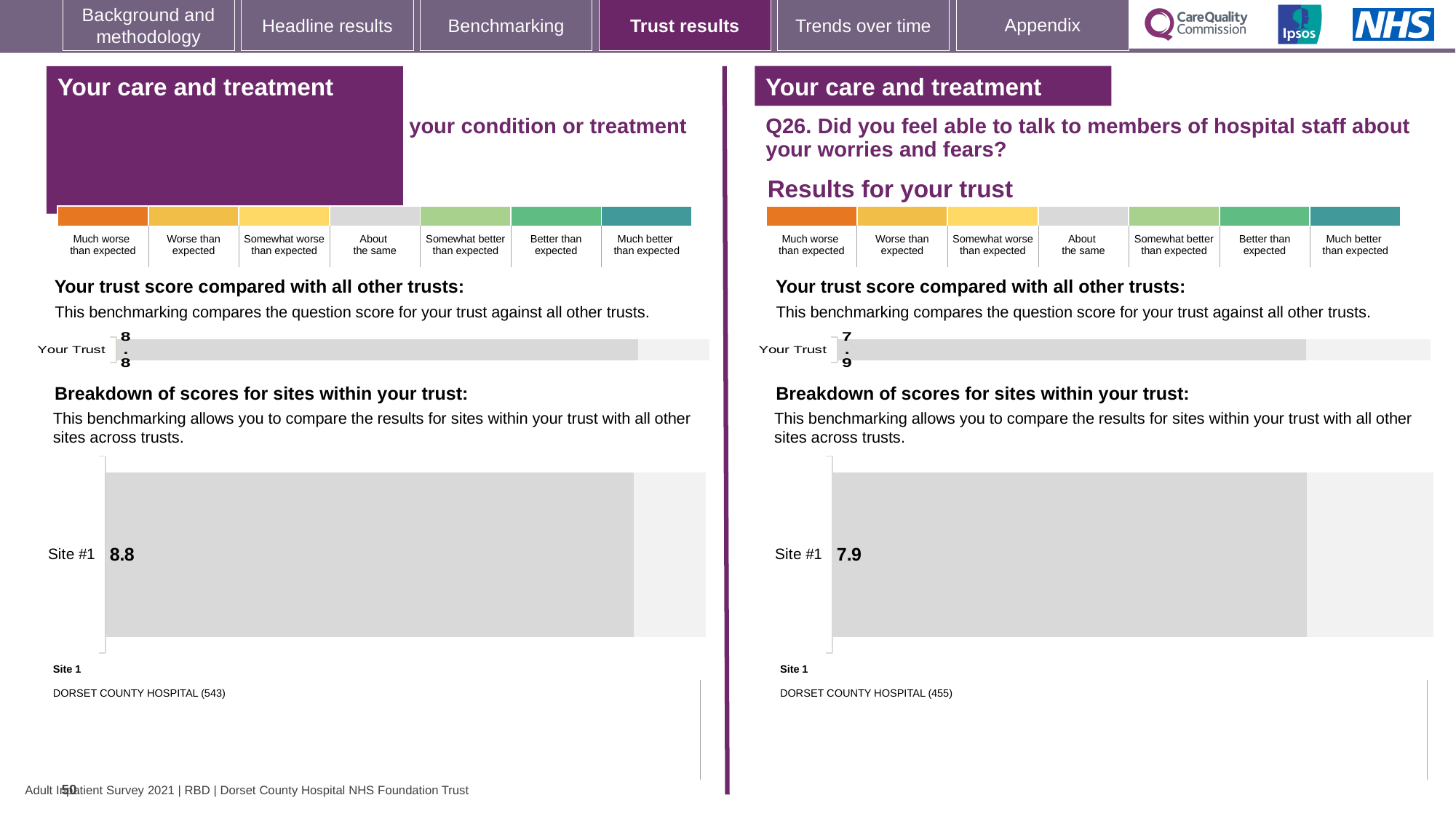
On the right half of the slide, which site name is listed under Site 1 in the breakdown of scores? DORSET COUNTY HOSPITAL (455) On the left half of the slide, which site name is listed under Site 1 in the breakdown of scores? DORSET COUNTY HOSPITAL (543) How many sites are shown in the 'Breakdown of scores for sites within your trust' chart on the right half of the slide (Q26)? 1 On the right half of the slide (Q26), in the 'Breakdown of scores for sites within your trust' chart, what is the value shown for Site #1? 7.9 How many sites are shown in the 'Breakdown of scores for sites within your trust' chart on the left half of the slide? 1 On the right half of the slide (Q26), in the 'Your trust score compared with all other trusts' chart, what is the value shown for Your Trust? 7.9 What type of chart is used to show the Site #1 score on the right half of the slide? Bar chart Which is larger: the Your Trust score in the left-hand chart or the Your Trust score in the right-hand (Q26) chart? The left-hand chart (8.8) On the left half of the slide, in the 'Breakdown of scores for sites within your trust' chart, what is the value shown for Site #1? 8.8 What is the difference between the Site #1 score on the left half of the slide and the Site #1 score on the right half (Q26)? 0.9 On the left half of the slide, in the 'Your trust score compared with all other trusts' chart, what is the value shown for Your Trust? 8.8 What is the difference between the Your Trust score on the left half of the slide and the Your Trust score on the right half (Q26)? 0.9